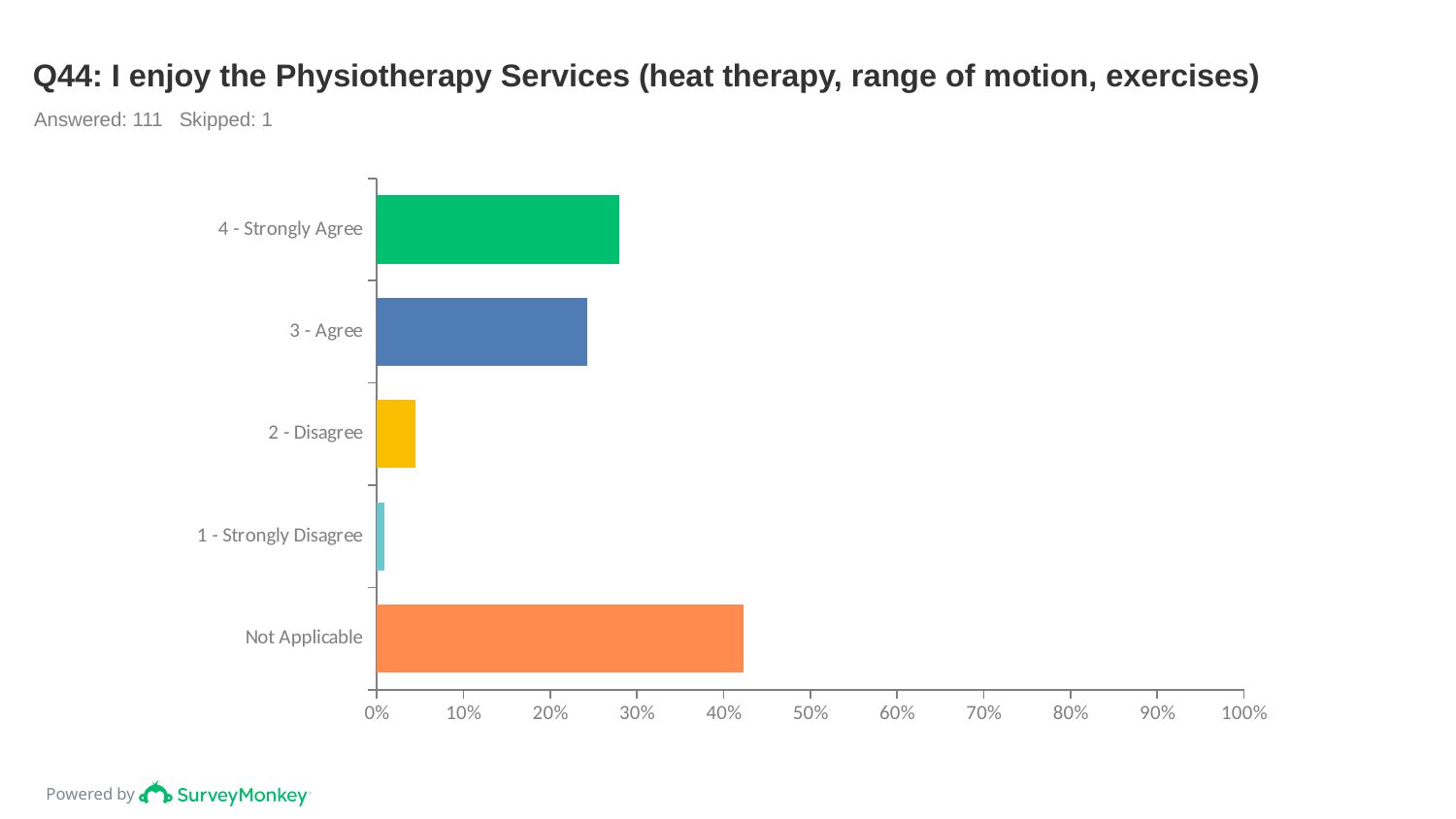
Which category has the lowest value? 1 - Strongly Disagree Which is larger, the value for 4 - Strongly Agree or the value for 2 - Disagree? 4 - Strongly Agree What is the title of the chart? Q44: I enjoy the Physiotherapy Services (heat therapy, range of motion, exercises) How many respondents answered this question according to the slide? 111 Is the value for Not Applicable greater or less than 40%? greater What kind of chart is shown on the slide? bar chart Is the value for 4 - Strongly Agree greater or less than 30%? less Is the value for 2 - Disagree greater or less than 10%? less How many categories are plotted on the chart? 5 Which category has the highest value? Not Applicable Which is larger, the value for Not Applicable or the value for 3 - Agree? Not Applicable